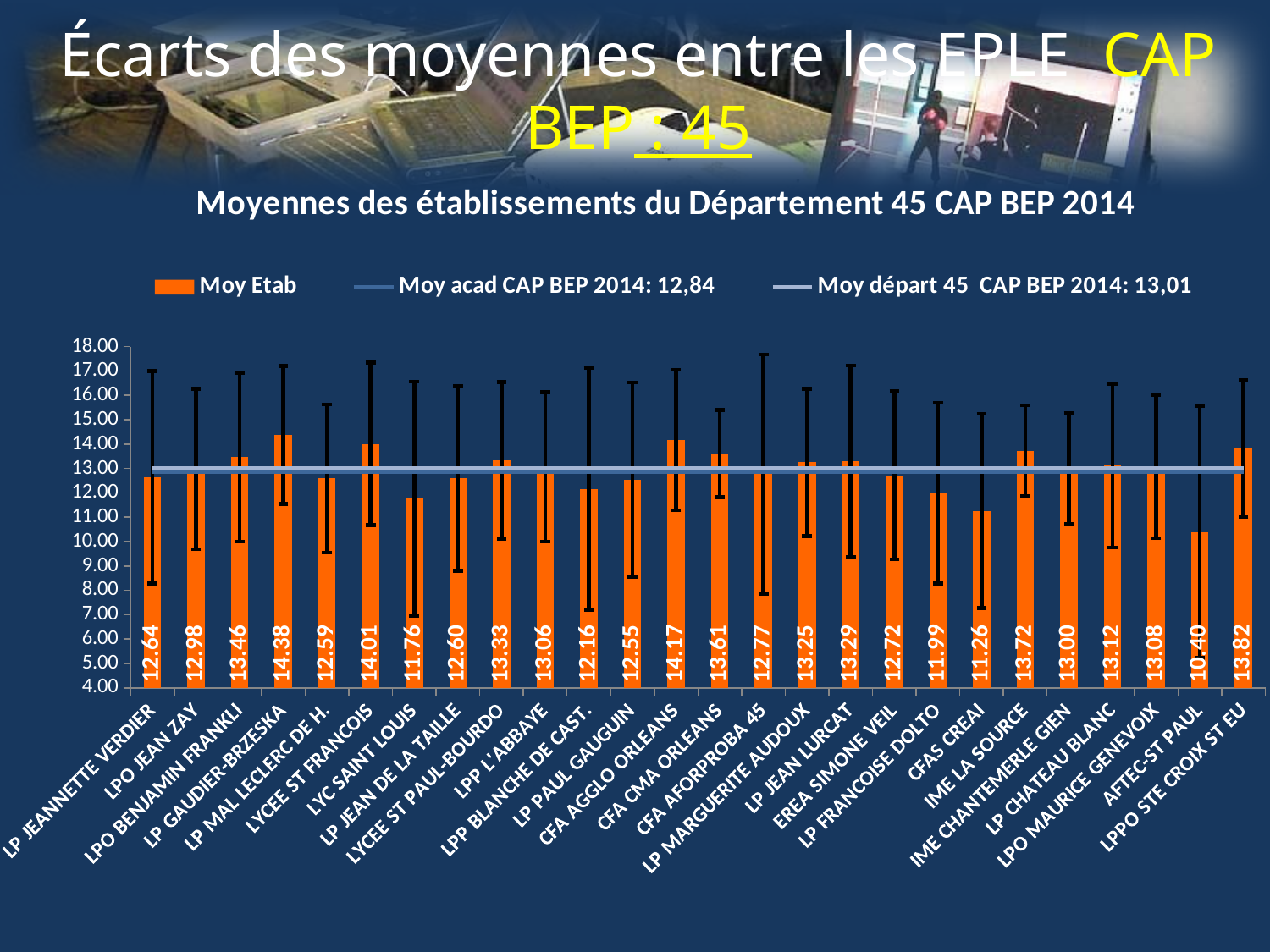
What is the Moy Etab value for LP GAUDIER-BRZESKA? 14.38 Which establishment has the lowest Moy Etab value? AFTEC-ST PAUL Which has a higher Moy Etab value, CFA CMA ORLEANS or LP FRANCOISE DOLTO? CFA CMA ORLEANS How many series does the legend list? 3 What is the difference between the Moy Etab values of LP GAUDIER-BRZESKA and AFTEC-ST PAUL? 3.98 What is the Moy Etab value for LYC SAINT LOUIS? 11.76 What kind of chart is used to show the Moy Etab values? bar chart According to the legend, what is the value of Moy départ 45 CAP BEP 2014? 13,01 What is the Moy Etab value for CFA AGGLO ORLEANS? 14.17 Is the Moy Etab value for CFAS CREAI greater or less than 12.00? less Which establishment has the highest Moy Etab value? LP GAUDIER-BRZESKA How many establishments are shown on the x axis of the chart? 26